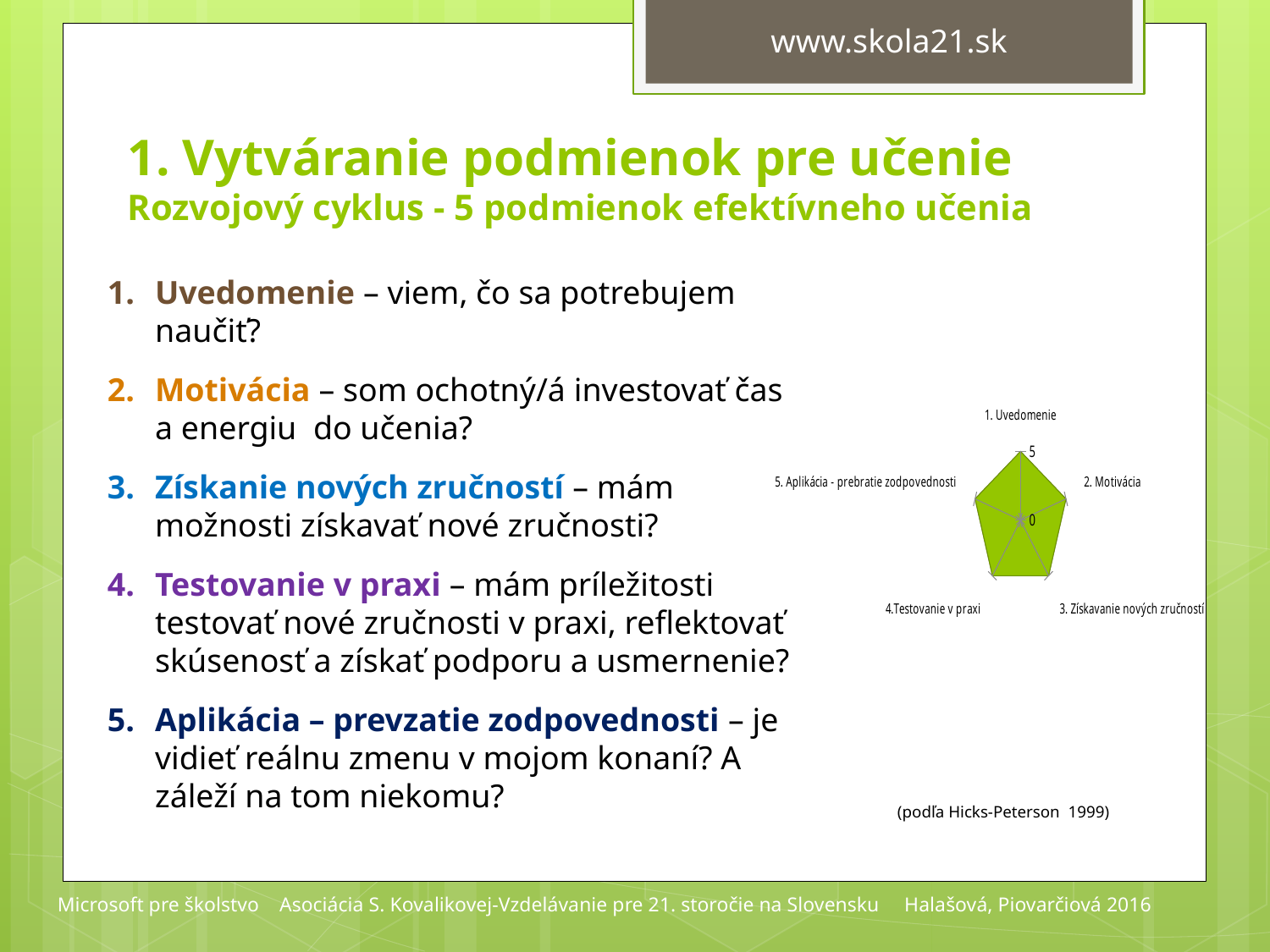
How many categories (axes) does the radar chart have? 5 What is the lowest value shown on the radar chart's axis scale? 0 Which category label appears on the left side of the radar chart? 5. Aplikácia - prebratie zodpovednosti What is the value for 1. Uvedomenie on the radar chart? 5 Is the value for 2. Motivácia on the radar chart greater or less than 0? greater Which category label appears at the top of the radar chart? 1. Uvedomenie Which category label appears at the bottom right of the radar chart? 3. Získavanie nových zručností What is the highest value shown on the radar chart's axis scale? 5 Which category label appears at the bottom left of the radar chart? 4.Testovanie v praxi What kind of chart is shown on the right side of the slide? radar chart